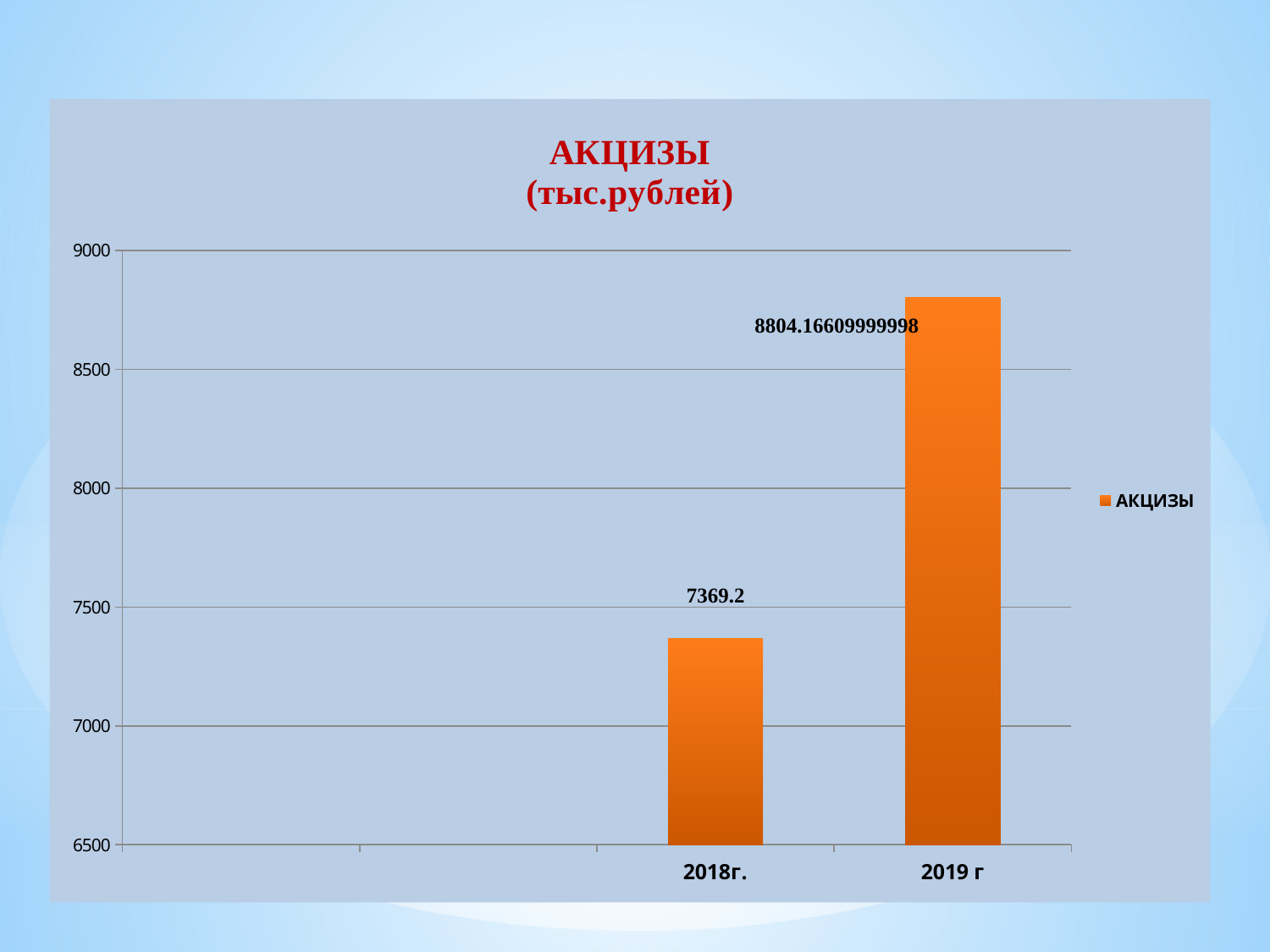
Which is larger, the value for 2018г. or the value for 2019 г? 2019 г What kind of chart is this? bar chart How many series does the legend list? 1 What is the value for 2019 г? 8804.16609999998 Which year has the highest value? 2019 г Is the value for 2019 г greater or less than 8500? greater How many categories are shown on the x axis? 2 What is the title of the chart? АКЦИЗЫ (тыс.рублей) What is the value for 2018г.? 7369.2 Do the values rise or fall from 2018г. to 2019 г? rise Which year has the lowest value? 2018г. Is the value for 2018г. greater or less than 7500? less